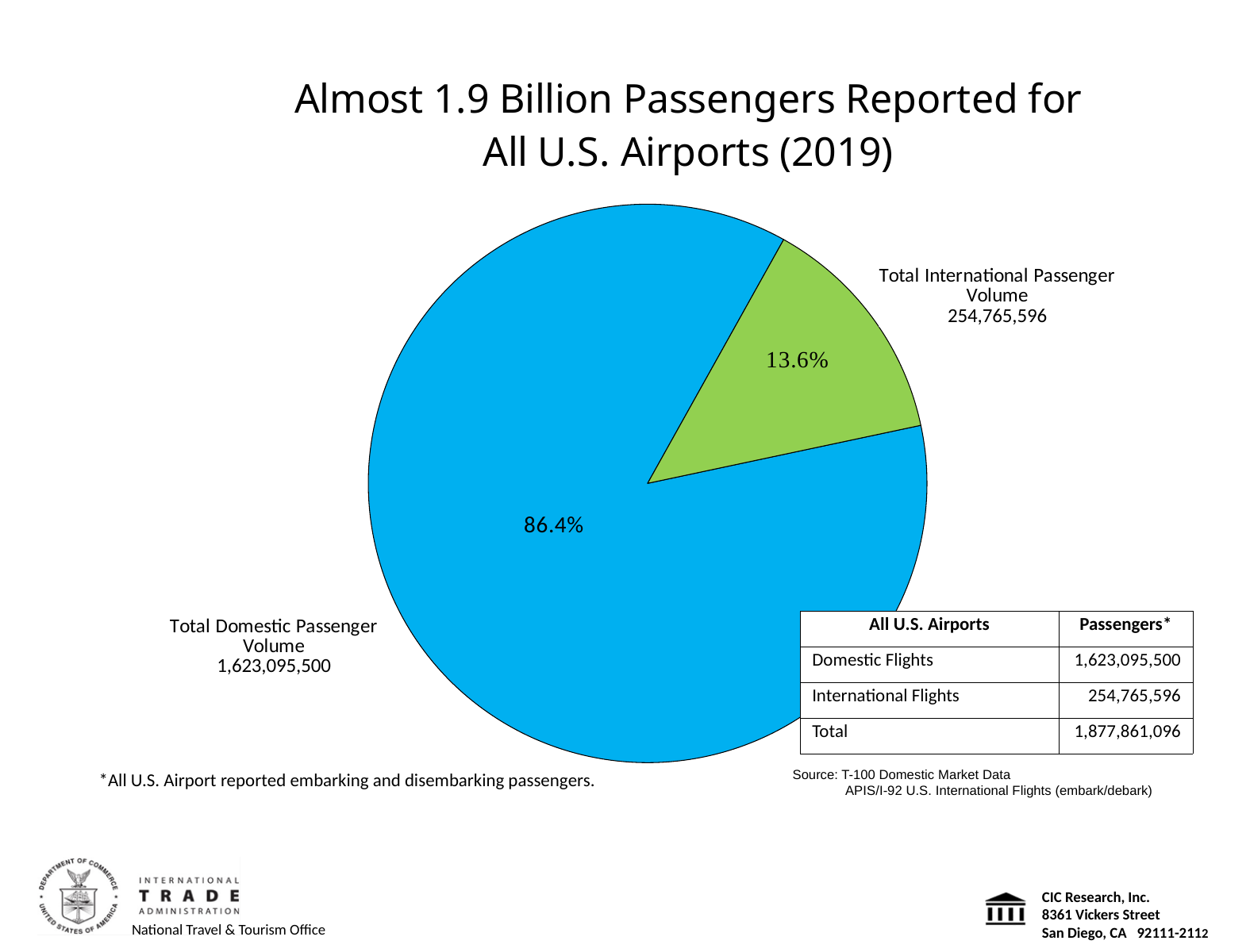
How many slices does the pie chart have? 2 What colour is the international passenger volume slice? green What percentage share of the pie does the domestic passenger volume slice represent? 86.4% What kind of chart is shown on the slide? pie chart What is the total number of passengers for all U.S. airports shown in the table? 1,877,861,096 What is the Total International Passenger Volume shown on the pie chart? 254,765,596 Which slice of the pie is larger, domestic or international passenger volume? Domestic What percentage share of the pie does the international passenger volume slice represent? 13.6% What is the difference between the domestic and international passenger volumes? 1,368,329,904 What is the Total Domestic Passenger Volume shown on the pie chart? 1,623,095,500 What is the title of the chart? Almost 1.9 Billion Passengers Reported for All U.S. Airports (2019) Which category has the smallest slice in the pie chart? Total International Passenger Volume